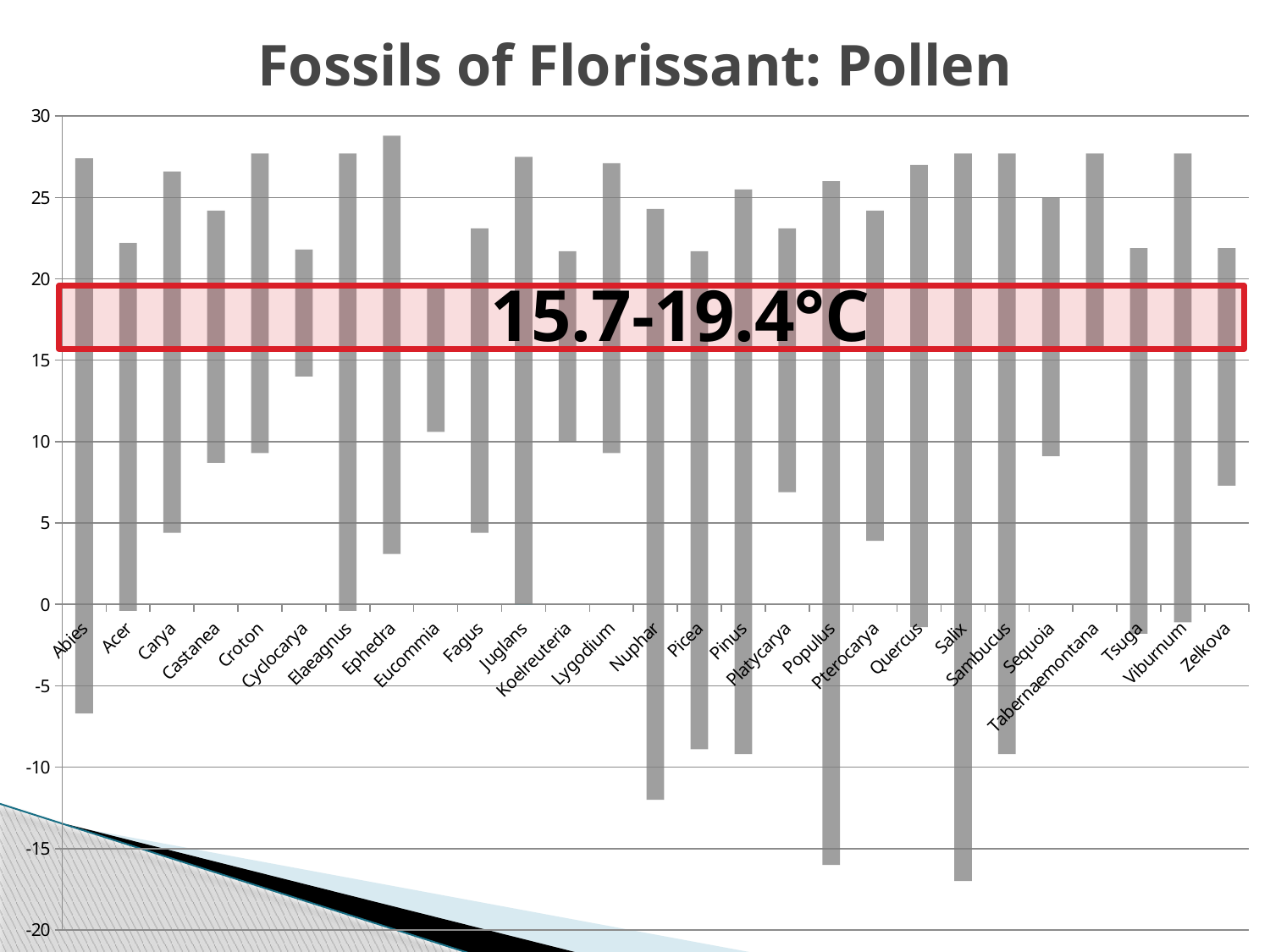
Which bar reaches a higher upper value, Abies or Acer? Abies Is the lower end of the Eucommia bar greater or less than 10? greater Is the lower end of the Nuphar bar greater or less than -10? less Is the upper end of the Ephedra bar greater or less than 25? greater How many pollen genera (categories) are plotted along the x axis? 27 What temperature range is written in the highlighted red band across the chart? 15.7-19.4°C Which category's bar reaches the highest value on the chart? Ephedra What is the title of the slide containing the chart? Fossils of Florissant: Pollen What kind of chart is shown on the slide? bar chart